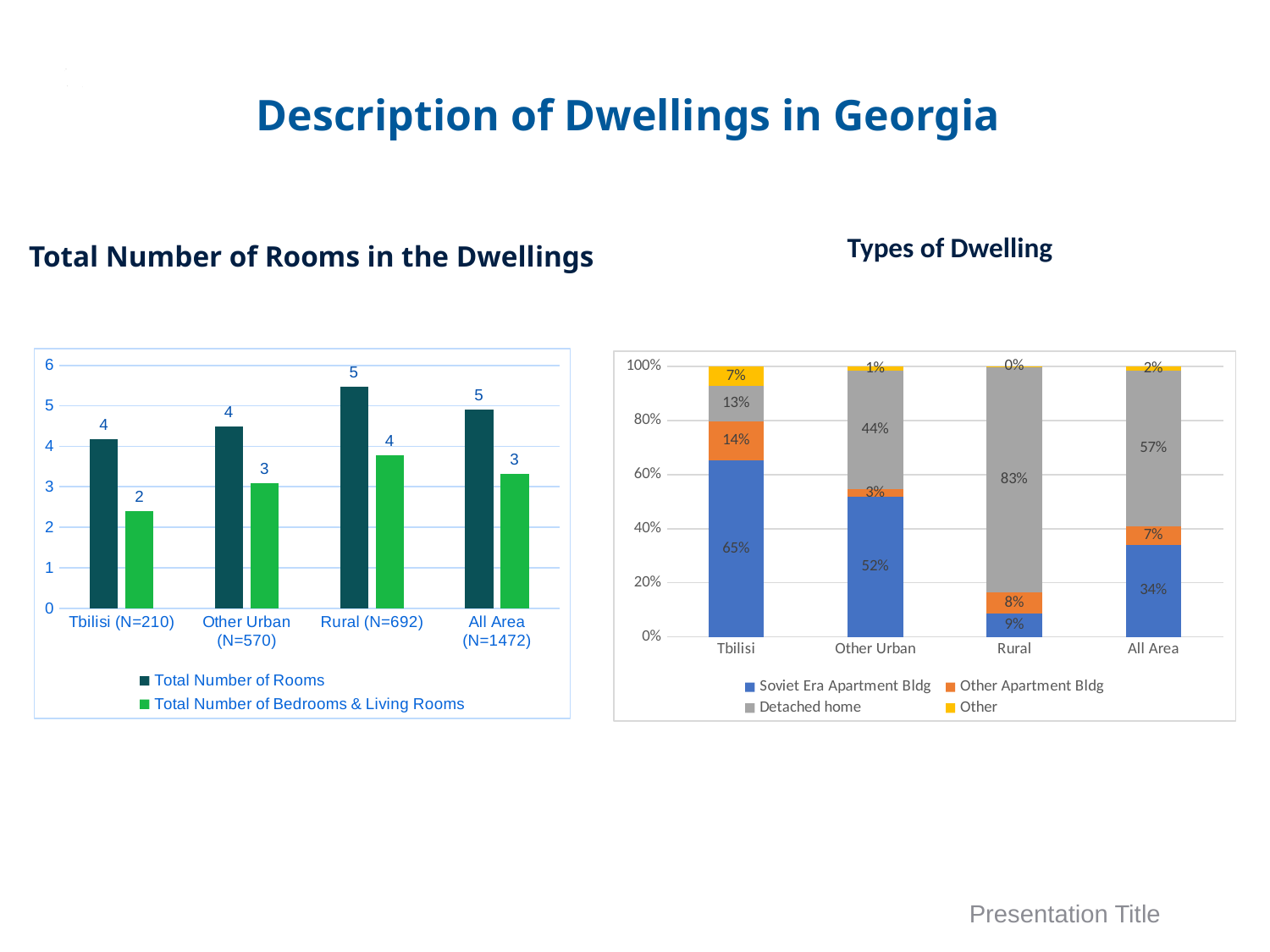
In the 'Types of Dwelling' chart, what percentage of dwellings in Rural are Detached home? 83% In the 'Types of Dwelling' chart, which colour represents Other? Yellow In the 'Types of Dwelling' chart, what percentage of dwellings in Tbilisi are Soviet Era Apartment Bldg? 65% What kind of chart is the 'Types of Dwelling' chart? Stacked bar chart In the 'Total Number of Rooms in the Dwellings' chart, how many series does the legend list? 2 In the 'Total Number of Rooms in the Dwellings' chart, what is the Total Number of Rooms for Rural (N=692)? 5 In the 'Total Number of Rooms in the Dwellings' chart, how many categories are shown on the x axis? 4 In the 'Total Number of Rooms in the Dwellings' chart, what is the Total Number of Bedrooms & Living Rooms for Tbilisi (N=210)? 2 In the 'Types of Dwelling' chart, which is larger: the Other Apartment Bldg share in Tbilisi or in All Area? Tbilisi In the 'Types of Dwelling' chart, which category has the highest share of Detached home? Rural In the 'Types of Dwelling' chart, what is the difference between the Detached home share in All Area and in Other Urban? 13% In the 'Total Number of Rooms in the Dwellings' chart, which category has the lowest Total Number of Bedrooms & Living Rooms? Tbilisi (N=210)